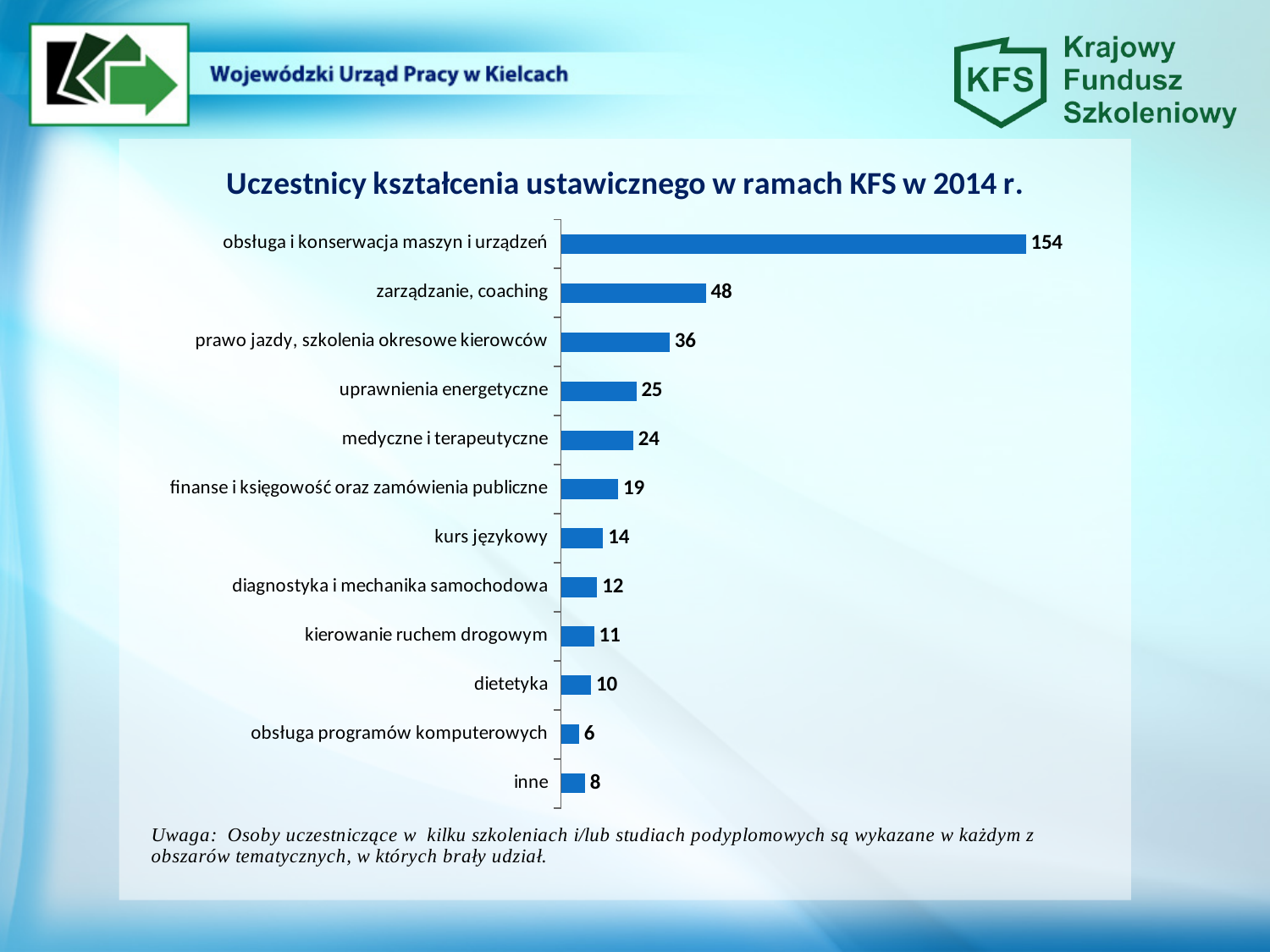
What kind of chart is shown on the slide? bar chart What is the value for "inne"? 8 Which category has the highest value? obsługa i konserwacja maszyn i urządzeń What is the difference between the values for "zarządzanie, coaching" and "prawo jazdy, szkolenia okresowe kierowców"? 12 Which category has the lowest value? obsługa programów komputerowych Which is larger, the value for "uprawnienia energetyczne" or "medyczne i terapeutyczne"? uprawnienia energetyczne What is the difference between the values for "dietetyka" and "obsługa programów komputerowych"? 4 What is the value for "obsługa i konserwacja maszyn i urządzeń"? 154 How many categories are shown in the chart? 12 What is the value for "zarządzanie, coaching"? 48 What is the value for "kurs językowy"? 14 What is the title of the chart? Uczestnicy kształcenia ustawicznego w ramach KFS w 2014 r.